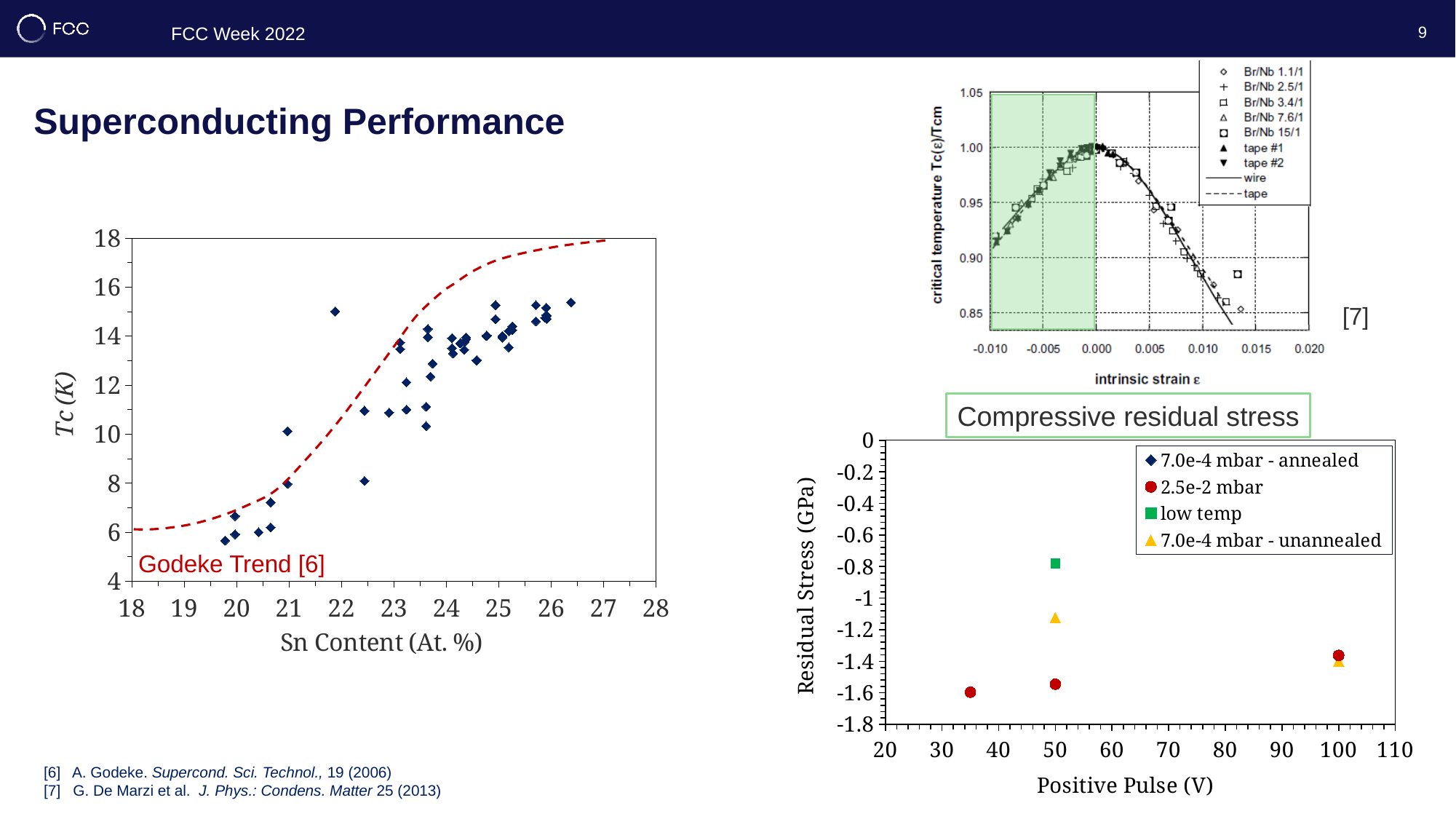
In the left chart, what is the x-axis label? Sn Content (At. %) In the bottom-right chart titled Compressive residual stress, how many series does the legend list? 4 In the top-right chart of critical temperature versus intrinsic strain, how many entries does the legend list? 9 In the top-right chart, at an intrinsic strain of 0.010, is the critical temperature ratio greater or less than 0.95? less In the bottom-right chart titled Compressive residual stress, is the low temp value at 50 V greater or less than -1? greater In the bottom-right chart titled Compressive residual stress, at 50 V which series has the highest (least negative) residual stress? low temp In the left chart, is the highest plotted Tc value greater or less than 16? less In the left chart, what is the red dashed line labelled? Godeke Trend [6] In the bottom-right chart titled Compressive residual stress, what is the x-axis label? Positive Pulse (V) In the left chart, does Tc generally rise or fall as Sn content increases? rise What kind of chart is the left chart with Tc (K) on the y axis? scatter plot